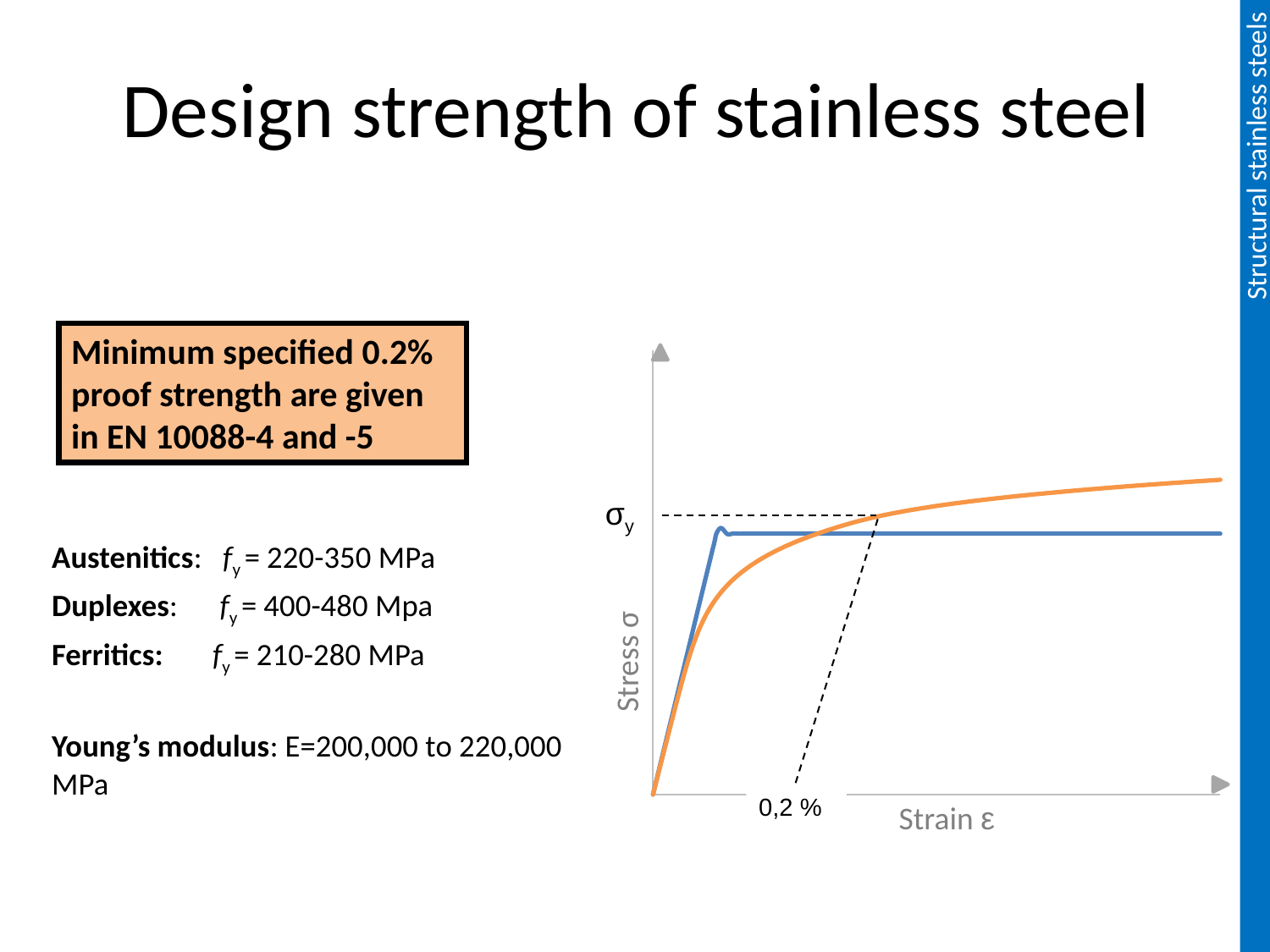
What is the label of the vertical axis of the chart? Stress σ At the right-hand end of the chart, which curve shows the higher stress, the blue or the orange one? orange What kind of chart is shown on the slide? line chart Does the orange curve rise or fall as strain increases along the x axis? rise What is the label of the horizontal axis of the chart? Strain ε How many curves are plotted on the stress-strain chart? 2 What symbol labels the stress level of the horizontal dashed line on the y axis? σy What strain value is marked on the x axis where the dashed offset line meets it? 0,2 %